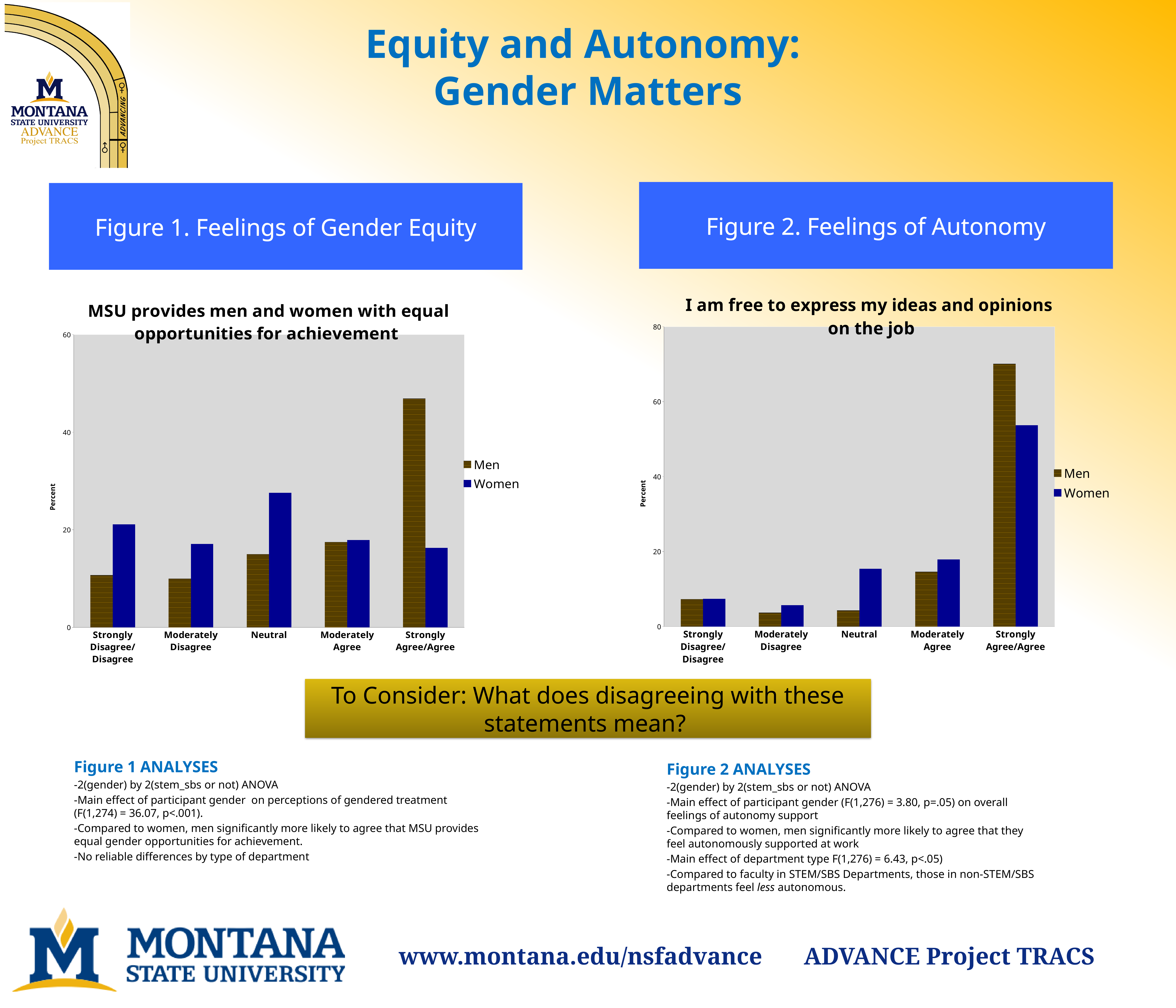
In Figure 2 (I am free to express my ideas and opinions on the job), which is larger for Strongly Agree/Agree, the Men value or the Women value? Men In Figure 1 (MSU provides men and women with equal opportunities for achievement), which is larger for Neutral, the Men value or the Women value? Women In Figure 1 (MSU provides men and women with equal opportunities for achievement), which category has the highest value for Women? Neutral In Figure 1 (MSU provides men and women with equal opportunities for achievement), how many response categories are shown on the x axis? 5 In Figure 1 (MSU provides men and women with equal opportunities for achievement), which category has the highest value for Men? Strongly Agree/Agree In Figure 2 (I am free to express my ideas and opinions on the job), is the Men value for Strongly Agree/Agree greater or less than 60? greater In Figure 2 (I am free to express my ideas and opinions on the job), which category has the highest value for Men? Strongly Agree/Agree In Figure 2 (I am free to express my ideas and opinions on the job), how many series does the legend list? 2 In Figure 1 (MSU provides men and women with equal opportunities for achievement), what kind of chart is shown? bar chart In Figure 1 (MSU provides men and women with equal opportunities for achievement), is the Men value for Strongly Agree/Agree greater or less than 40? greater In Figure 2 (I am free to express my ideas and opinions on the job), which category has the lowest value for Men? Moderately Disagree In Figure 2 (I am free to express my ideas and opinions on the job), what colour are the Women bars? blue